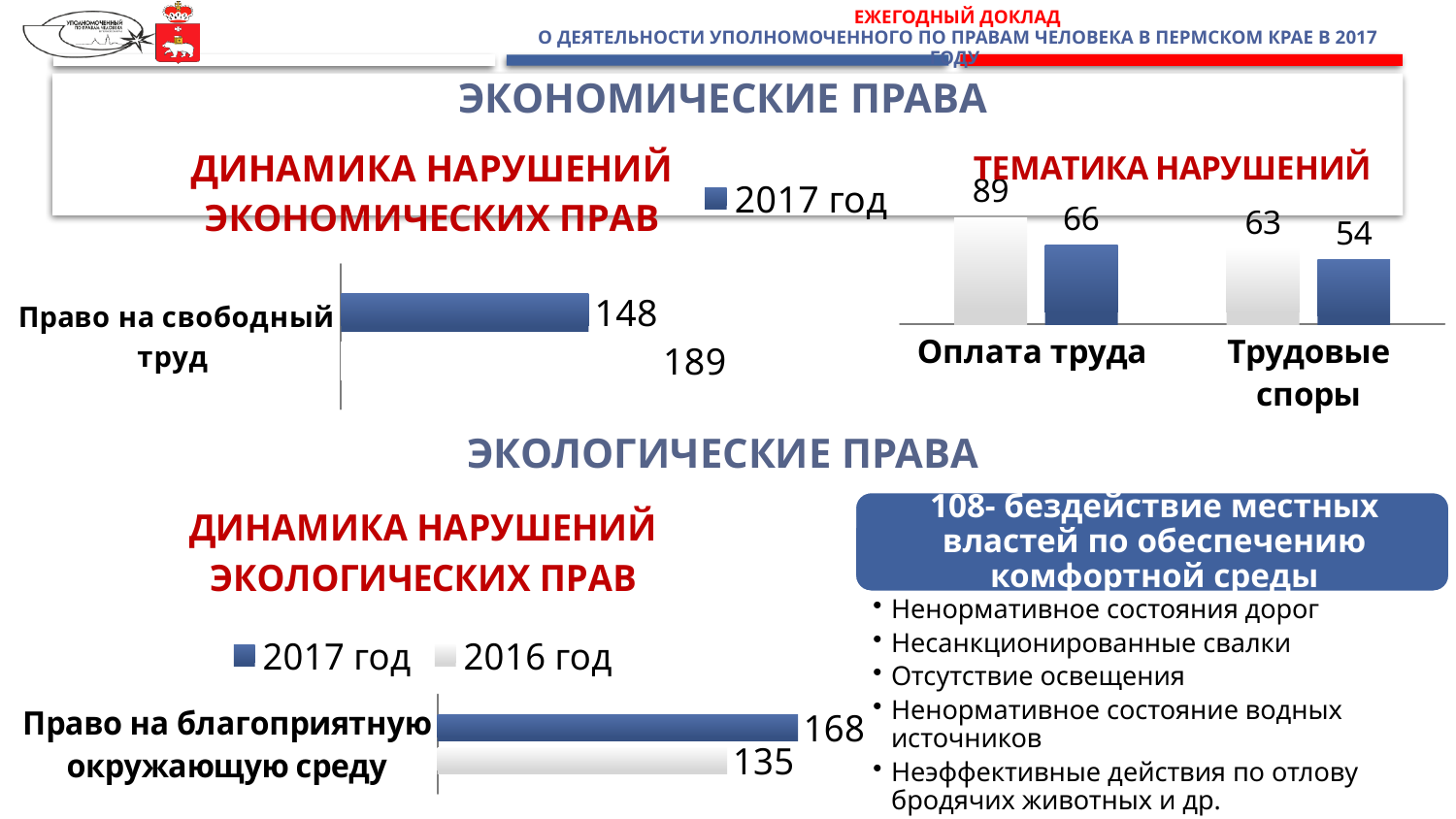
In the chart 'ДИНАМИКА НАРУШЕНИЙ ЭКОЛОГИЧЕСКИХ ПРАВ', which year has the larger value, 2017 год or 2016 год? 2017 год In the chart 'ТЕМАТИКА НАРУШЕНИЙ', what is the value of the light grey bar for 'Трудовые споры'? 63 How many series does the legend of the chart 'ДИНАМИКА НАРУШЕНИЙ ЭКОЛОГИЧЕСКИХ ПРАВ' list? 2 In the chart 'ДИНАМИКА НАРУШЕНИЙ ЭКОЛОГИЧЕСКИХ ПРАВ', what is the difference between the 2017 год and 2016 год values? 33 What kind of chart is 'ДИНАМИКА НАРУШЕНИЙ ЭКОЛОГИЧЕСКИХ ПРАВ'? Bar chart In the chart 'ТЕМАТИКА НАРУШЕНИЙ', which bar is the highest? Light grey bar for Оплата труда (89) In the chart 'ДИНАМИКА НАРУШЕНИЙ ЭКОНОМИЧЕСКИХ ПРАВ', what is the value for 2017 год for 'Право на свободный труд'? 148 In the chart 'ТЕМАТИКА НАРУШЕНИЙ', what is the value of the blue bar for 'Оплата труда'? 66 How many categories are shown on the x axis of the chart 'ТЕМАТИКА НАРУШЕНИЙ'? 2 In the chart 'ДИНАМИКА НАРУШЕНИЙ ЭКОЛОГИЧЕСКИХ ПРАВ', what is the value for 2016 год? 135 In the chart 'ДИНАМИКА НАРУШЕНИЙ ЭКОНОМИЧЕСКИХ ПРАВ', what is the other value printed next to the 2017 год value of 148? 189 In the chart 'ДИНАМИКА НАРУШЕНИЙ ЭКОЛОГИЧЕСКИХ ПРАВ', what is the value for 2017 год for 'Право на благоприятную окружающую среду'? 168